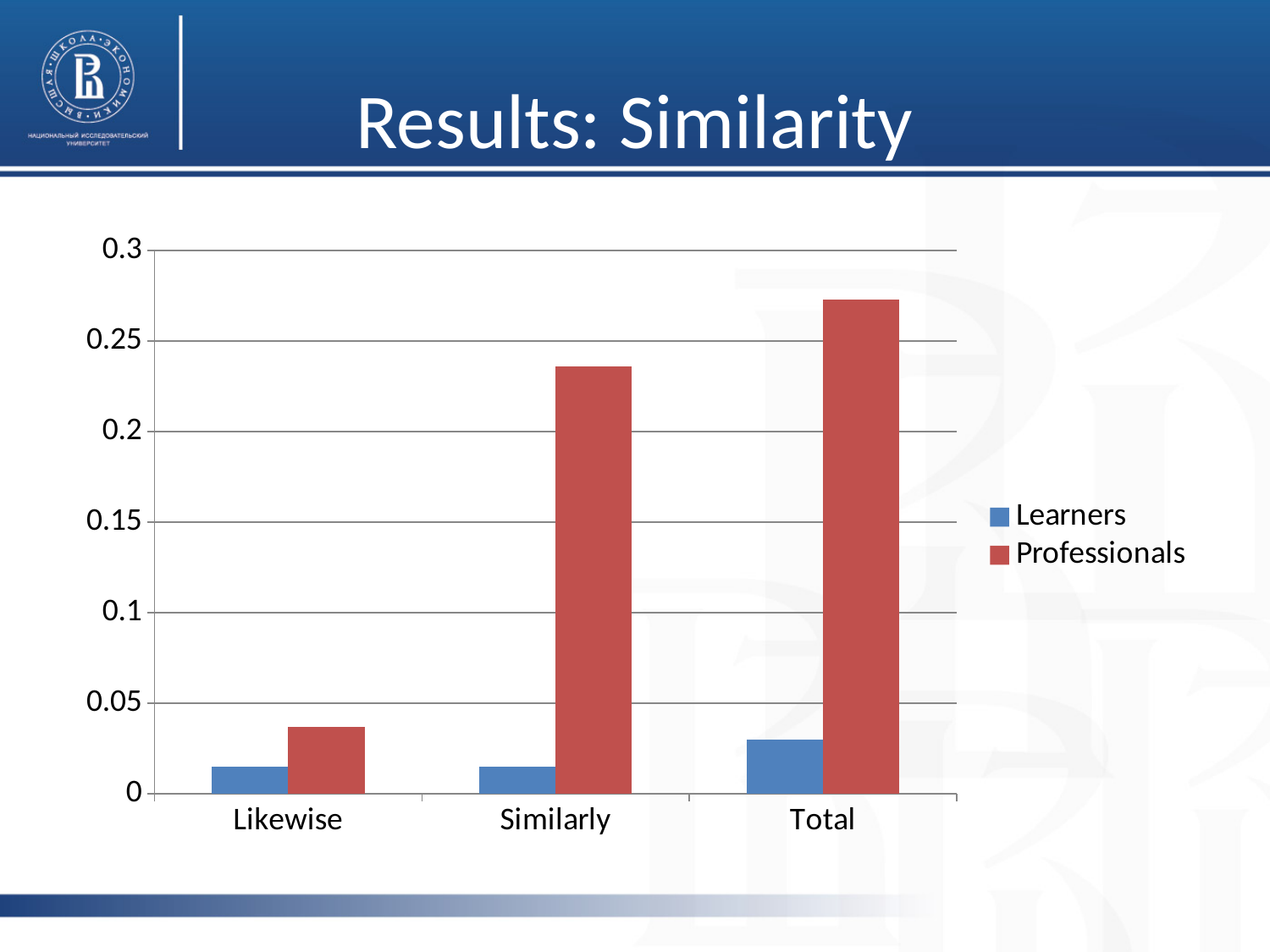
Which category has the highest value for Learners? Total Is the value for Learners in Total greater or less than 0.05? less How many categories are shown on the x axis? 3 Is the value for Professionals in Similarly greater or less than 0.2? greater How many series does the legend list? 2 Is the value for Professionals in Likewise greater or less than 0.05? less Which category has the lowest value for Professionals? Likewise What is the title of the slide containing the chart? Results: Similarity In the Similarly category, which is larger: Learners or Professionals? Professionals Which category has the highest value for Professionals? Total What kind of chart is shown on the slide? bar chart